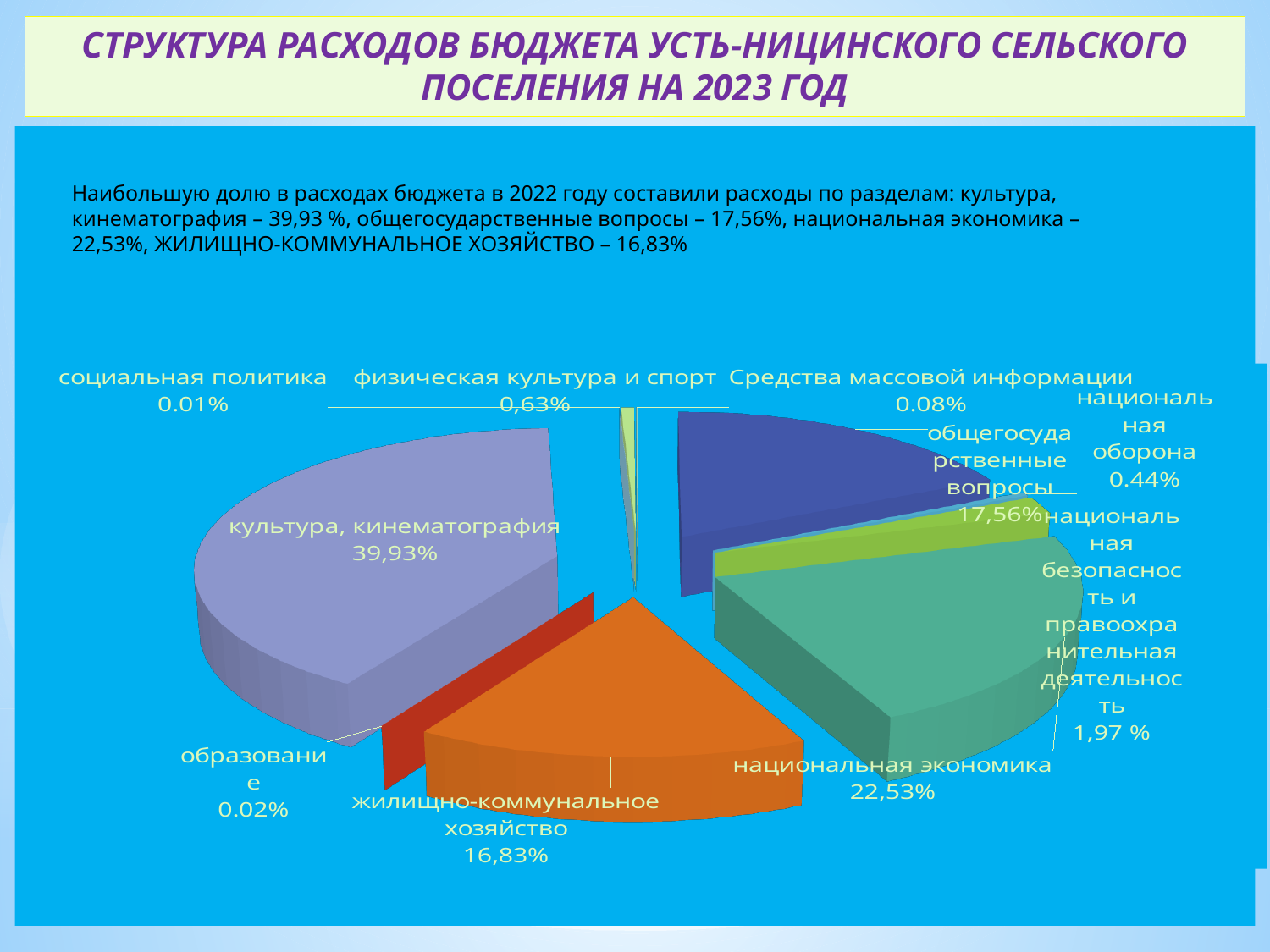
Which category has the smallest share of the pie? социальная политика Which category has the largest share of the pie? культура, кинематография What percentage is shown for жилищно-коммунальное хозяйство? 16,83% What is the difference between the shares of национальная экономика and общегосударственные вопросы? 4,97% Which is larger: the share for общегосударственные вопросы or for жилищно-коммунальное хозяйство? общегосударственные вопросы What is the value shown for общегосударственные вопросы? 17,56% What colour is the slice for национальная экономика? green What is the value shown for национальная экономика? 22,53% What share is shown for национальная оборона? 0.44% What share of the budget expenditure does культура, кинематография account for? 39,93% What type of chart is shown on the slide? pie chart How many categories are shown in the pie chart? 10